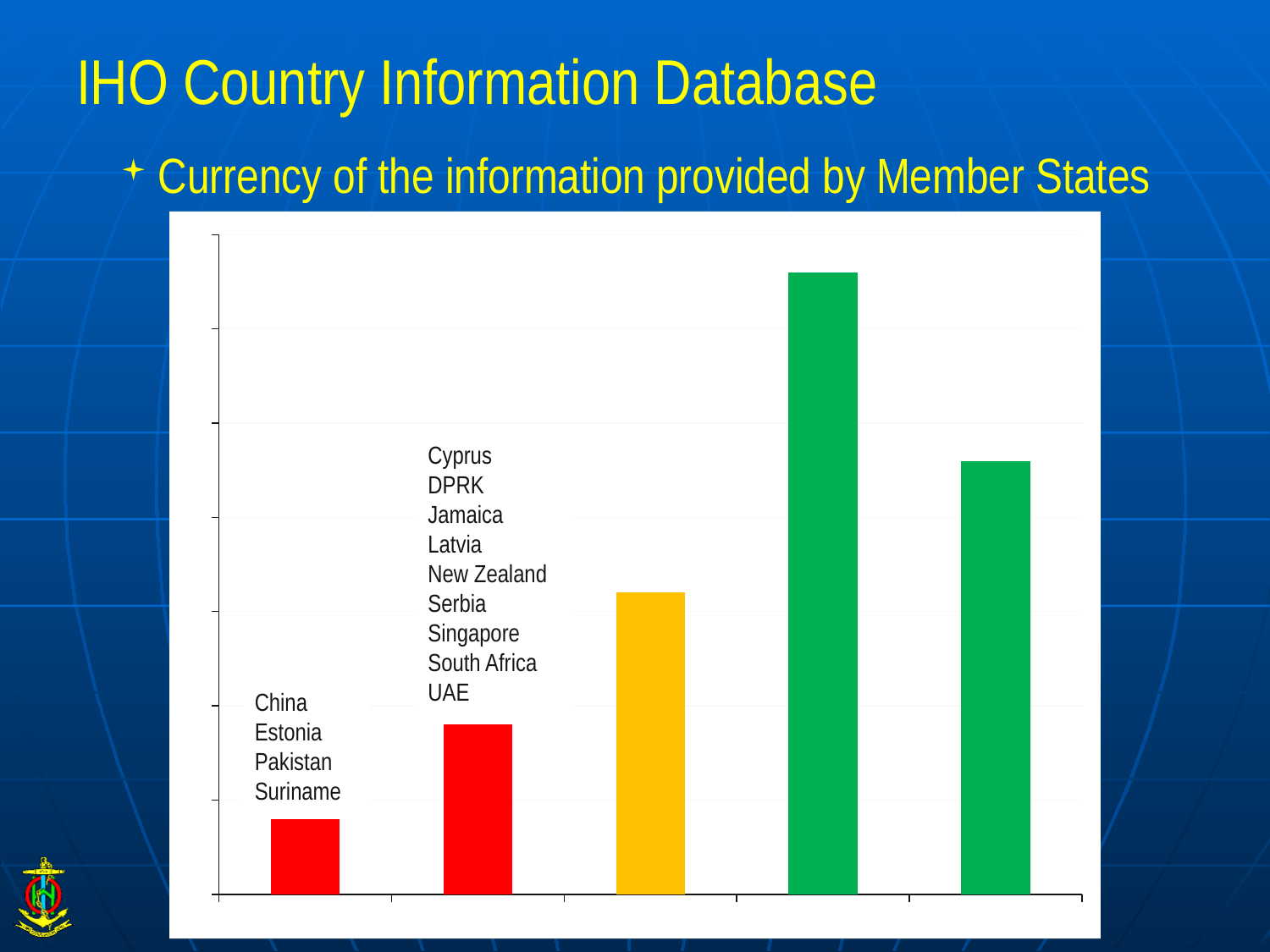
Which is taller, the first bar or the second bar? the second bar Which is taller, the third bar or the fifth bar? the fifth bar Which is taller, the second bar or the third bar? the third bar Which countries are listed next to the first (leftmost) bar? China, Estonia, Pakistan, Suriname Which bar is the tallest in the chart? the fourth bar from the left What colour is the tallest bar in the chart? green What kind of chart is shown on the slide? bar chart Which bar is the shortest in the chart? the first bar from the left How many bars are plotted in the chart? 5